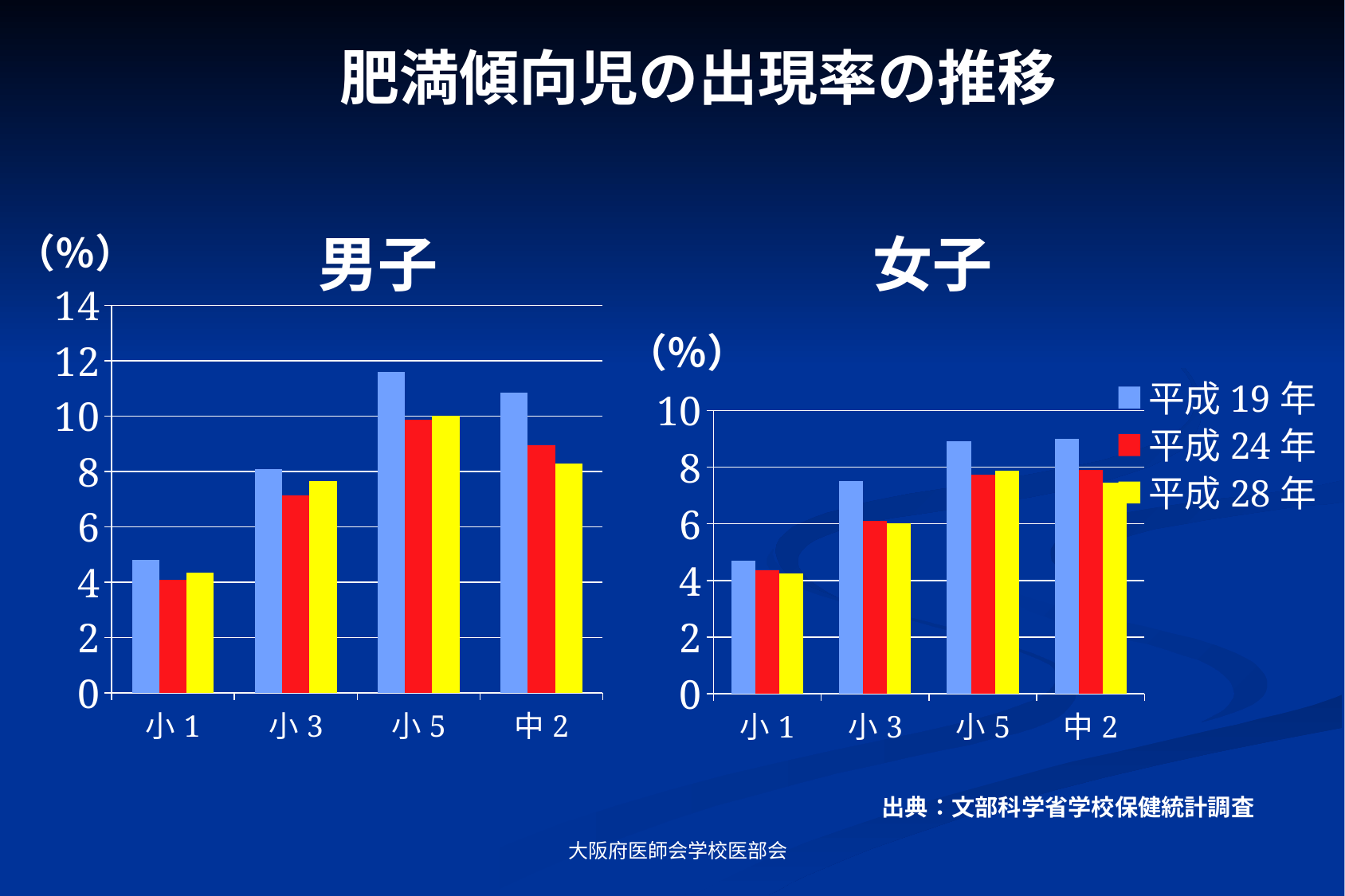
In the 女子 chart, for 小3, which is larger: 平成19年 or 平成28年? 平成19年 In the 男子 chart, for 小5, which is larger: 平成19年 or 平成24年? 平成19年 In the 男子 chart, which category has the highest value for 平成19年? 小5 In the 男子 chart, is the value for 小5 in 平成19年 greater or less than 10? greater In the 男子 chart, is the value for 小1 in 平成24年 greater or less than 6? less What is the title of the slide? 肥満傾向児の出現率の推移 How many categories are shown on the x axis of the 女子 chart? 4 In the 女子 chart, is the value for 中2 in 平成28年 greater or less than 8? less In the 男子 chart, which category has the lowest value for 平成24年? 小1 In the 女子 chart, which category has the lowest value for 平成28年? 小1 What kind of chart is the 男子 chart? bar chart How many series does the legend list? 3